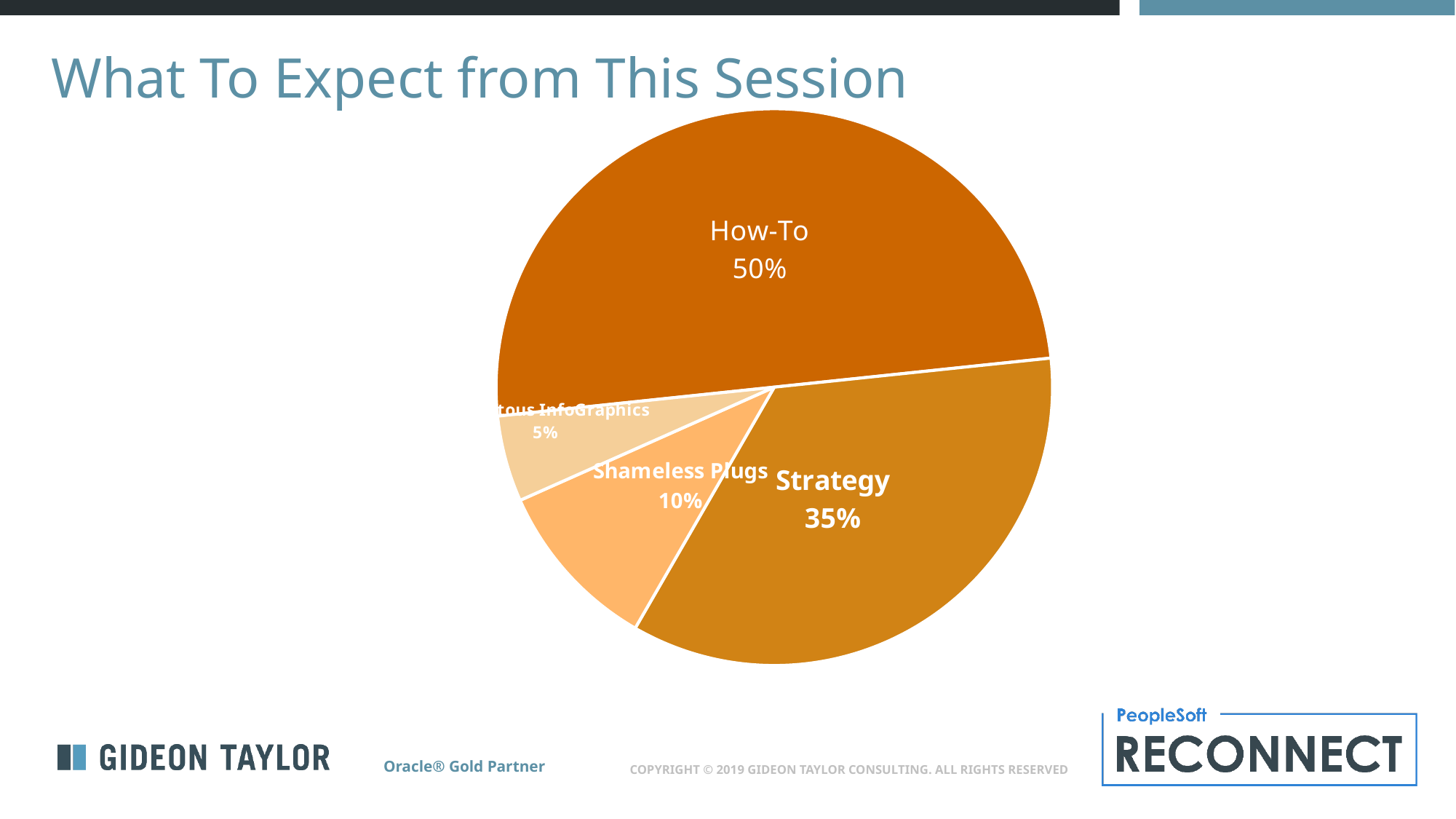
What is the title of the slide containing the pie chart? What To Expect from This Session What share of the pie does How-To take? 50% What kind of chart is shown on the slide? pie chart What share of the pie does Strategy take? 35% Is the Strategy slice greater or less than half of the pie? less Which of the labelled slices is larger, Strategy or Shameless Plugs? Strategy What share of the pie does Shameless Plugs take? 10% What is the difference in percentage points between the Strategy slice and the Shameless Plugs slice? 25% What is the difference in percentage points between the How-To slice and the Strategy slice? 15% How many slices does the pie chart have? 4 Which slice of the pie is the largest? How-To What is the combined share of the How-To and Strategy slices? 85%